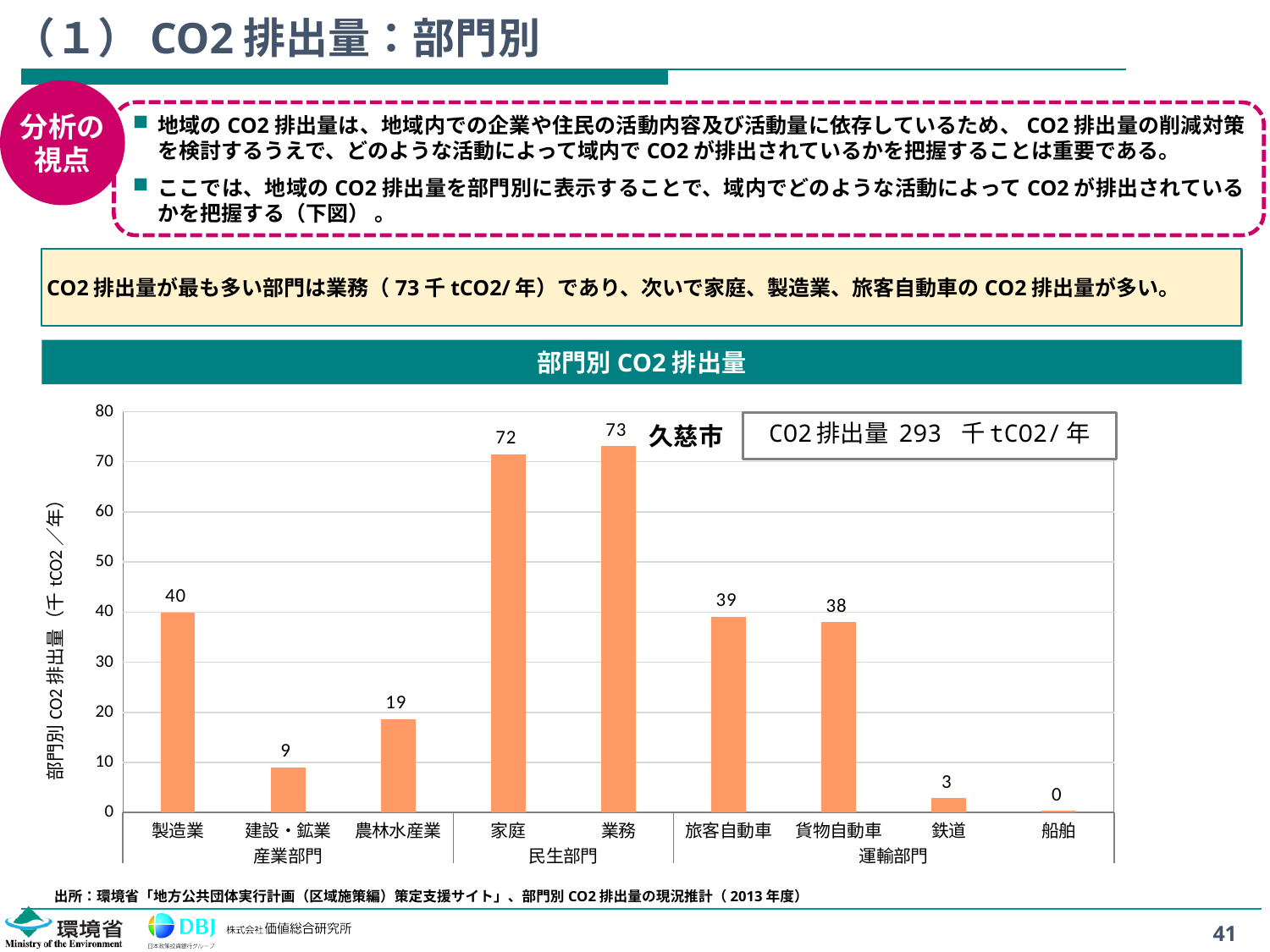
Which is larger, the value for 旅客自動車 or the value for 建設・鉱業? 旅客自動車 Which sector has the highest CO2 emissions in the chart? 業務 What total CO2 emission value for 久慈市 is shown in the box on the chart? 293 千tCO2/年 What is the CO2 emission value for 製造業 in the 部門別CO2排出量 chart? 40 What is the difference between the values for 製造業 and 農林水産業? 21 What is the difference between the values for 業務 and 家庭? 1 What is the unit shown on the vertical axis of the chart? 千tCO2／年 What is the value shown for 家庭 in the chart? 72 What is the value shown for 鉄道 in the chart? 3 What kind of chart is used to show 部門別CO2排出量? bar chart Which sector has the lowest CO2 emissions in the chart? 船舶 How many sectors (bars) are shown in the chart? 9